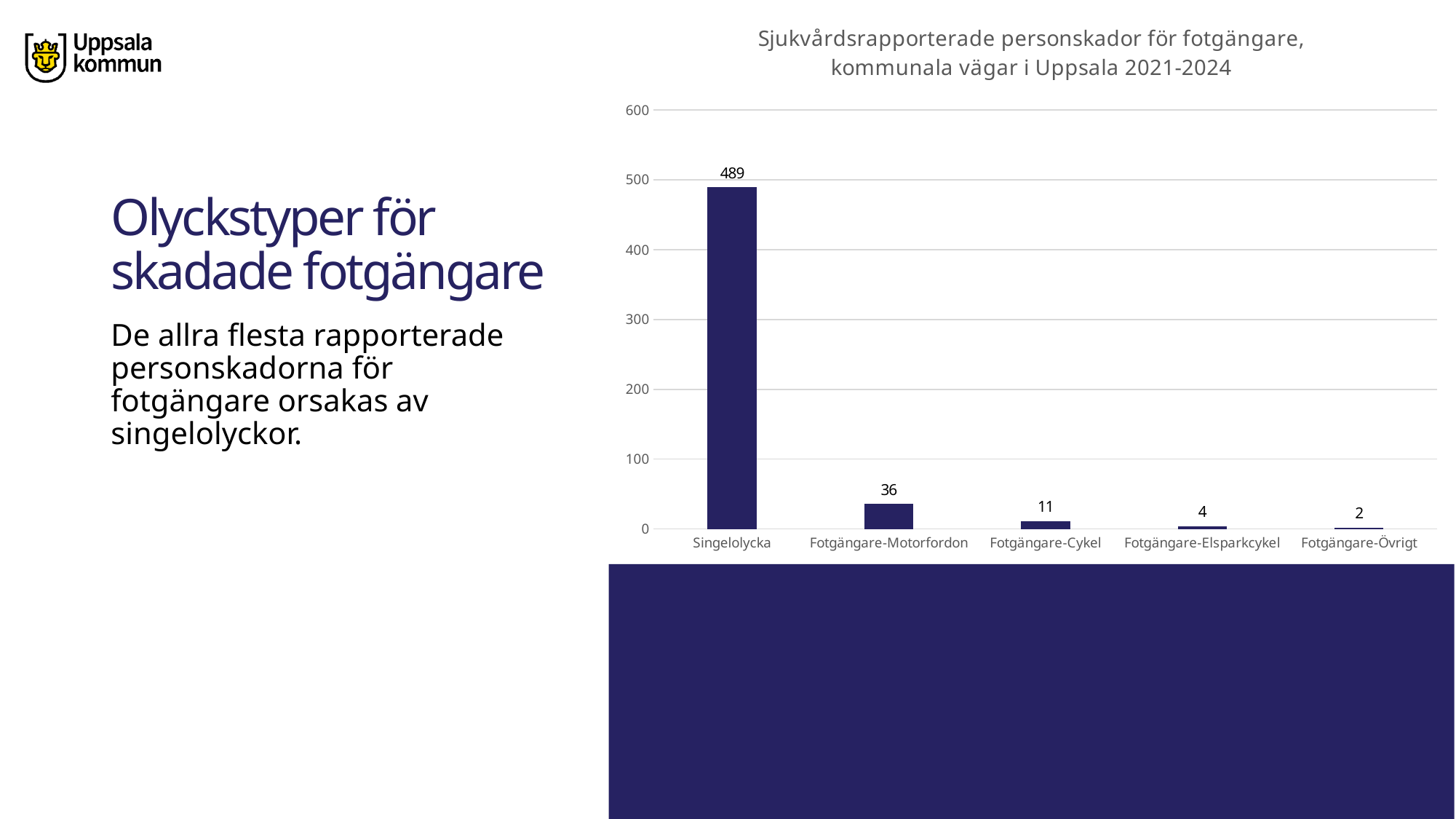
What is the value for Fotgängare-Elsparkcykel? 4 What is the value for Fotgängare-Cykel? 11 What is the value for Fotgängare-Övrigt? 2 What kind of chart is shown on the slide? Bar chart What is the value for Singelolycka? 489 How many categories are shown on the x axis? 5 What is the difference between the values for Singelolycka and Fotgängare-Motorfordon? 453 Which category has the highest value? Singelolycka Which category has the lowest value? Fotgängare-Övrigt What is the title of the chart? Sjukvårdsrapporterade personskador för fotgängare, kommunala vägar i Uppsala 2021-2024 What is the value for Fotgängare-Motorfordon? 36 Which is larger, the value for Fotgängare-Cykel or Fotgängare-Elsparkcykel? Fotgängare-Cykel